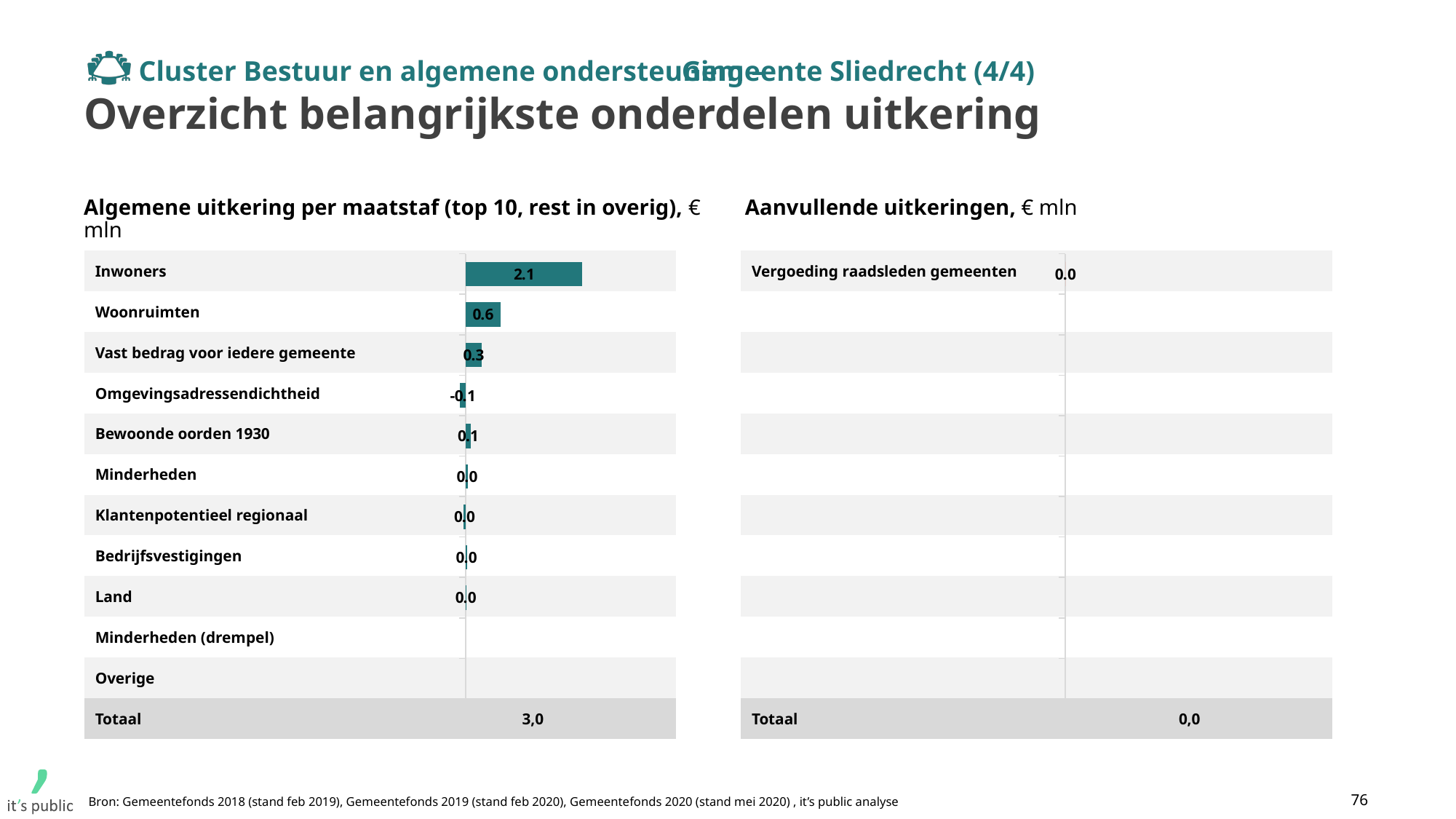
In the chart 'Algemene uitkering per maatstaf', what is the value for Vast bedrag voor iedere gemeente? 0.3 In the chart 'Algemene uitkering per maatstaf', what is the value for Inwoners? 2.1 In the chart 'Algemene uitkering per maatstaf', what is the difference between the values for Inwoners and Woonruimten? 1.5 In the chart 'Algemene uitkering per maatstaf', which is larger: Woonruimten or Vast bedrag voor iedere gemeente? Woonruimten In the chart 'Algemene uitkering per maatstaf', which category has the lowest value? Omgevingsadressendichtheid In the chart 'Algemene uitkering per maatstaf', what is the value for Woonruimten? 0.6 In the chart 'Aanvullende uitkeringen', what is the Totaal shown at the bottom? 0,0 In the chart 'Algemene uitkering per maatstaf', what is the Totaal shown at the bottom? 3,0 In the chart 'Algemene uitkering per maatstaf', which category has the highest value? Inwoners What kind of chart is 'Algemene uitkering per maatstaf'? Bar chart In the chart 'Algemene uitkering per maatstaf', what is the value for Omgevingsadressendichtheid? -0.1 In the chart 'Aanvullende uitkeringen', what is the value for Vergoeding raadsleden gemeenten? 0.0